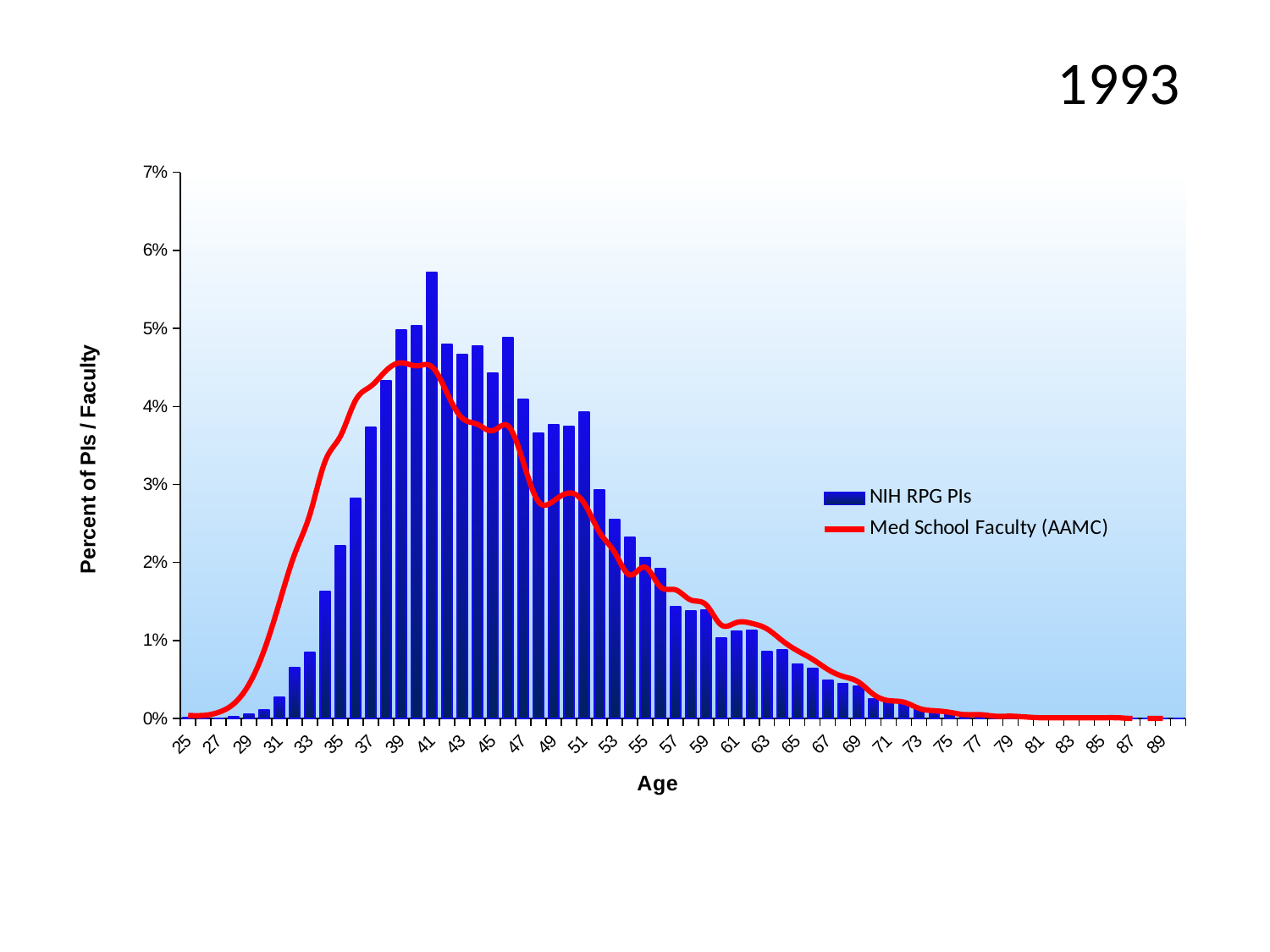
Is the Med School Faculty (AAMC) value at age 39 greater or less than 4%? greater How many series does the legend list? 2 Is the NIH RPG PIs value at age 41 greater or less than 5%? greater Is the NIH RPG PIs value at age 37 greater or less than 3%? greater What is the title of the y axis? Percent of PIs / Faculty What kind of chart is shown on the slide? bar chart (with a line overlay) At age 33, which series has the higher value, NIH RPG PIs or Med School Faculty (AAMC)? Med School Faculty (AAMC) What are the two series named in the legend? NIH RPG PIs and Med School Faculty (AAMC) At which age is the NIH RPG PIs bar the tallest? 41 From age 41 to age 69, do the NIH RPG PIs bars generally rise or fall? fall